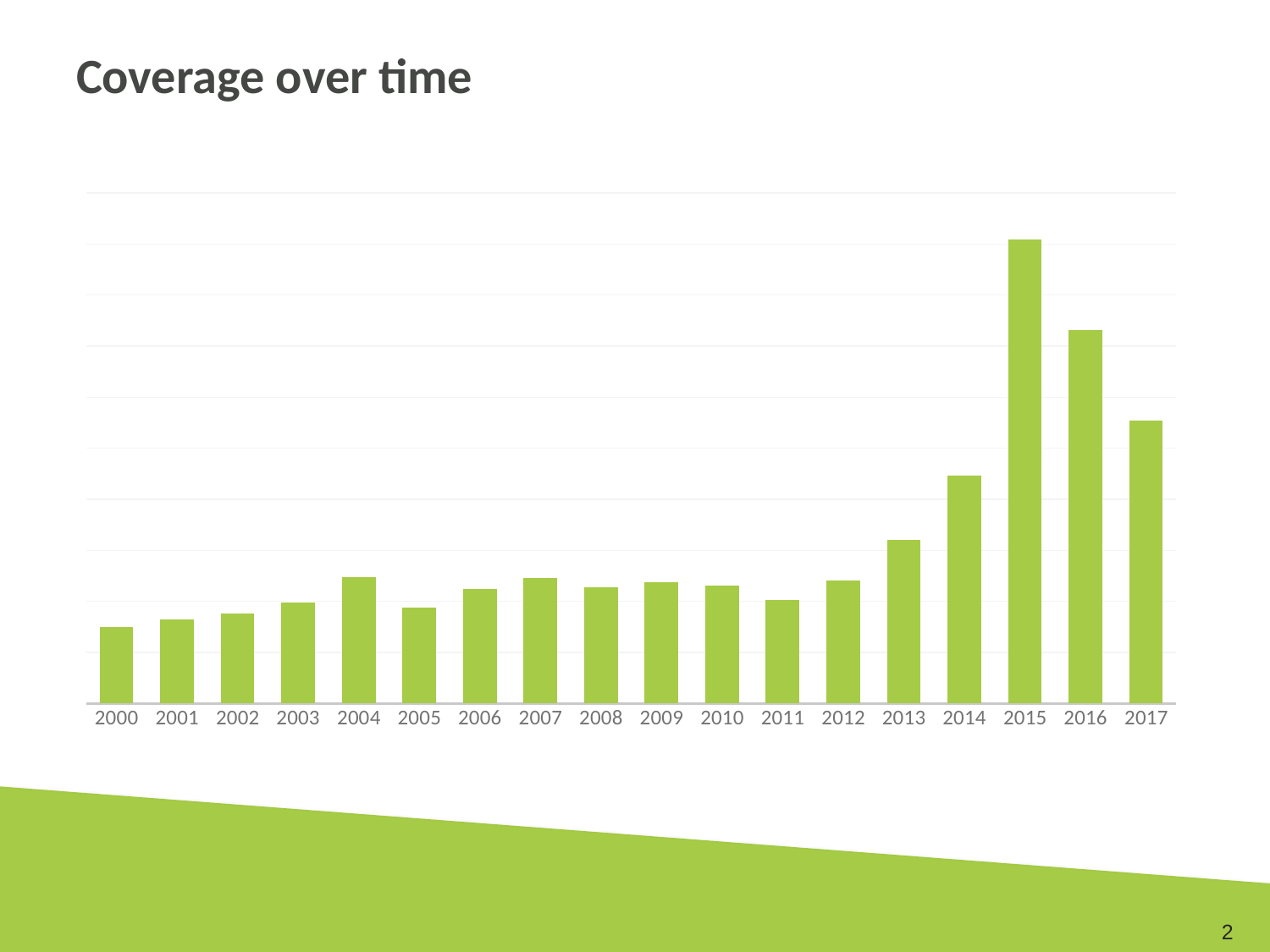
Do the values rise or fall from 2015 to 2017? Fall What kind of chart is shown on the slide? Bar chart Which year has the higher value, 2010 or 2011? 2010 Which year has the higher value, 2004 or 2005? 2004 Which year has the higher value, 2013 or 2014? 2014 Which year has the highest bar in the chart? 2015 What colour are the bars in the chart? Green What is the title of the chart? Coverage over time How many years are shown on the x axis of the chart? 18 Do the values rise or fall from 2012 to 2015? Rise Which year has the lowest bar in the chart? 2000